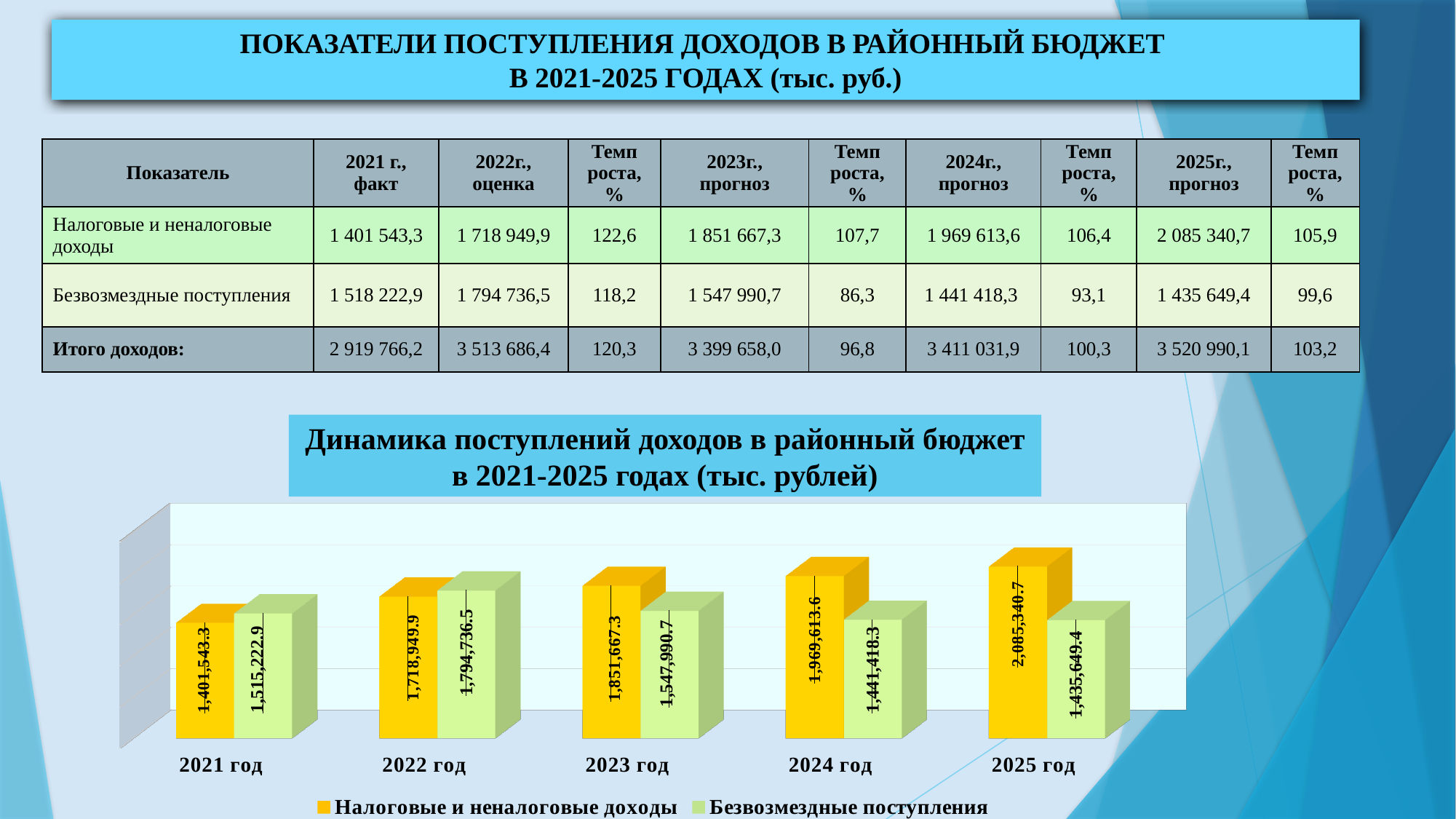
In the chart, which year has the lowest value for 'Налоговые и неналоговые доходы'? 2021 год In the chart, what is the difference between 'Налоговые и неналоговые доходы' and 'Безвозмездные поступления' for 2025 год? 649,691.3 In the chart, what is the value of 'Безвозмездные поступления' for 2022 год? 1,794,736.5 How many series does the chart's legend list? 2 In the chart, what is the value of 'Безвозмездные поступления' for 2023 год? 1,547,990.7 What type of chart is shown under the title 'Динамика поступлений доходов в районный бюджет в 2021-2025 годах'? bar chart In the chart, which is larger for 2022 год: 'Налоговые и неналоговые доходы' or 'Безвозмездные поступления'? Безвозмездные поступления In the chart, do the values for 'Налоговые и неналоговые доходы' rise or fall from 2021 год to 2025 год? rise How many years (categories) are shown on the x axis of the chart? 5 In the chart, what is the value of 'Налоговые и неналоговые доходы' for 2025 год? 2,085,340.7 In the chart, which year has the highest value for 'Налоговые и неналоговые доходы'? 2025 год In the chart, what is the value of 'Налоговые и неналоговые доходы' for 2021 год? 1,401,543.3